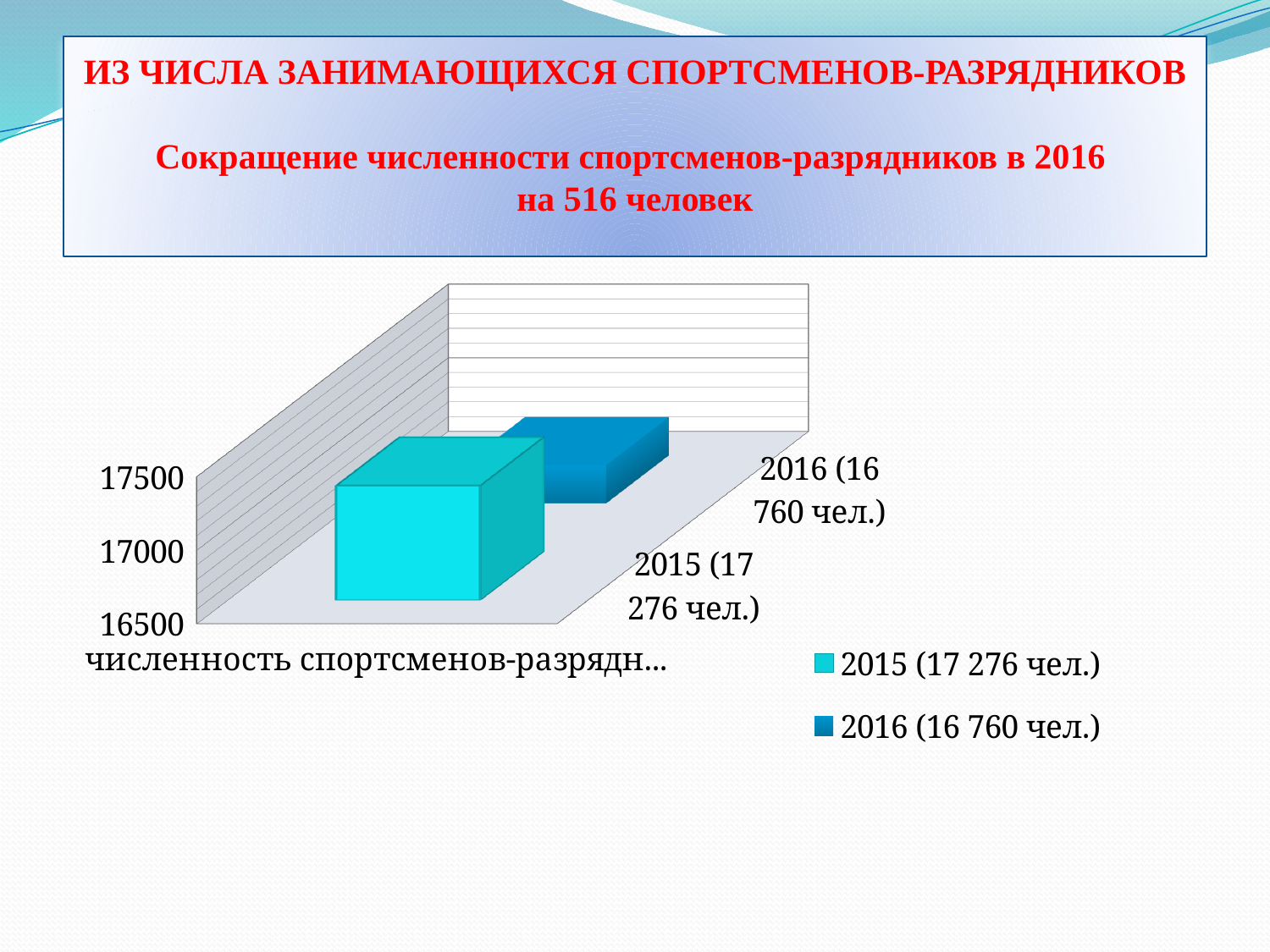
What is the lowest tick value shown on the vertical axis? 16500 What is the number of ranked athletes for 2016 according to the legend? 16 760 чел. What is the number of ranked athletes for 2015 according to the legend? 17 276 чел. By how much did the number of ranked athletes decrease from 2015 to 2016? 516 Which year has the higher number of ranked athletes, 2015 or 2016? 2015 Is the value for 2016 greater or less than 17000? less Is the value for 2015 greater or less than 17000? greater Which year has the highest value on the chart? 2015 Which year has the lowest value on the chart? 2016 Do the values rise or fall from 2015 to 2016? fall How many series does the legend list? 2 What kind of chart is shown on the slide? bar chart